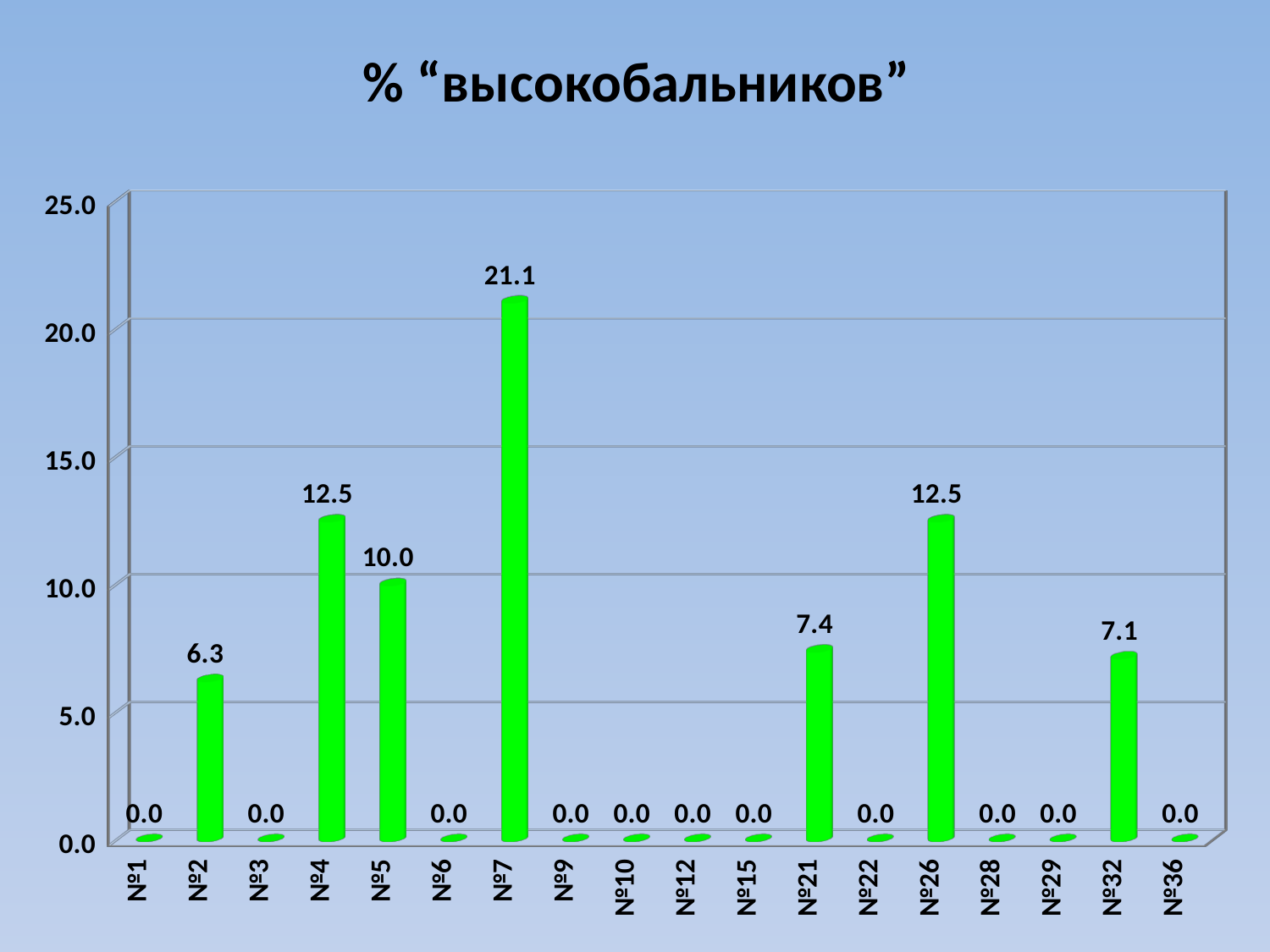
What is the difference between the values for №5 and №2? 3.7 What is the difference between the values for №7 and №4? 8.6 What is the value for №26? 12.5 Which is larger, the value for №4 or the value for №5? №4 What is the value for №2? 6.3 How many categories are shown on the x axis? 18 What is the value for №7? 21.1 What is the title of the chart? % “высокобальников” What is the value for №32? 7.1 What kind of chart is shown on the slide? bar chart Is the value for №7 greater or less than 20.0? greater Which category has the highest value? №7